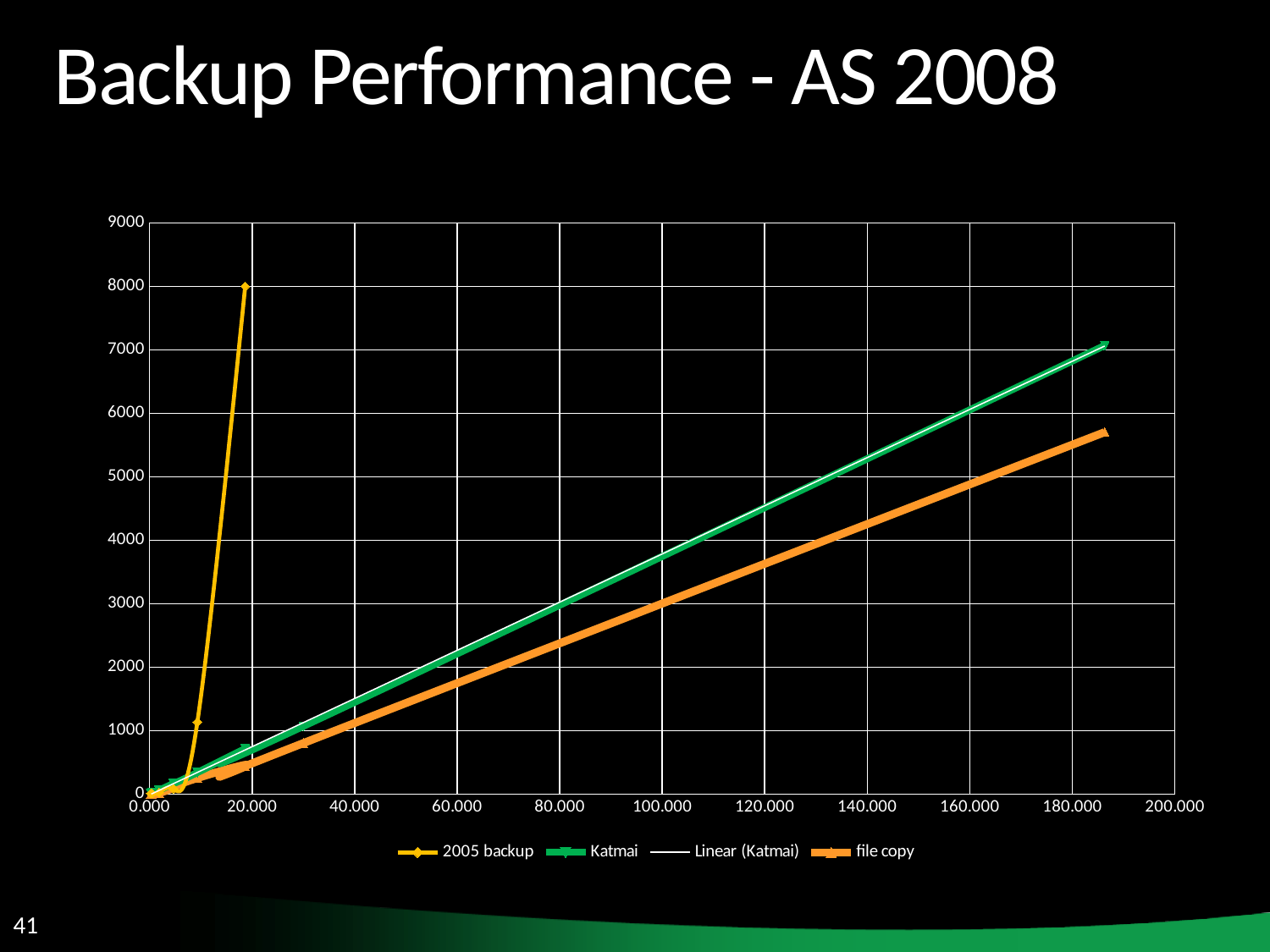
What colour is the file copy series drawn in? orange Which series reaches the highest value on the chart? 2005 backup Is the highest value of the 2005 backup series greater or less than 7000? greater What is the maximum value shown on the vertical axis? 9000 Is the final value of the Katmai series greater or less than 6000? greater Does the Katmai series rise or fall as the x-axis value increases? rise At the right end of the chart (around 180.000 on the x axis), which series is higher: Katmai or file copy? Katmai What kind of chart is shown on the slide? line chart How many series does the legend list? 4 Which series rises most steeply on the chart? 2005 backup Is the final value of the file copy series greater or less than 6000? less